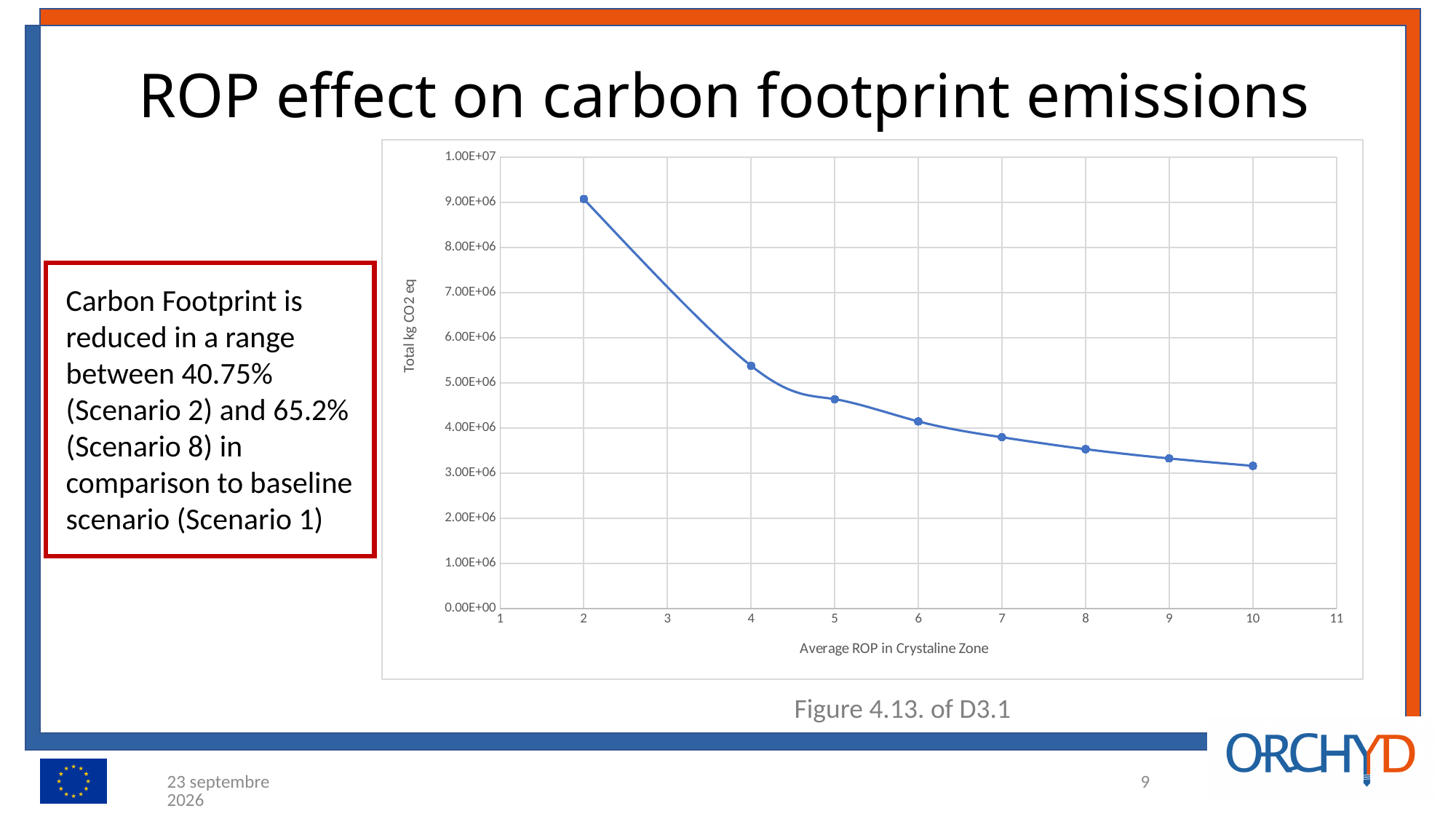
Is the value for Average ROP 6 greater or less than 4.00E+06? greater At which Average ROP value is Total kg CO2 eq lowest? 10 Which has the larger Total kg CO2 eq, Average ROP 4 or Average ROP 7? Average ROP 4 What is the title of the chart's y axis? Total kg CO2 eq At which Average ROP value is Total kg CO2 eq highest? 2 Do the values rise or fall as Average ROP in Crystaline Zone increases along the x axis? fall What is the title of the chart's x axis? Average ROP in Crystaline Zone Is the value for Average ROP 4 greater or less than 5.00E+06? greater What kind of chart is shown on the slide? line chart How many data points are plotted on the chart? 8 Is the value for Average ROP 10 greater or less than 4.00E+06? less